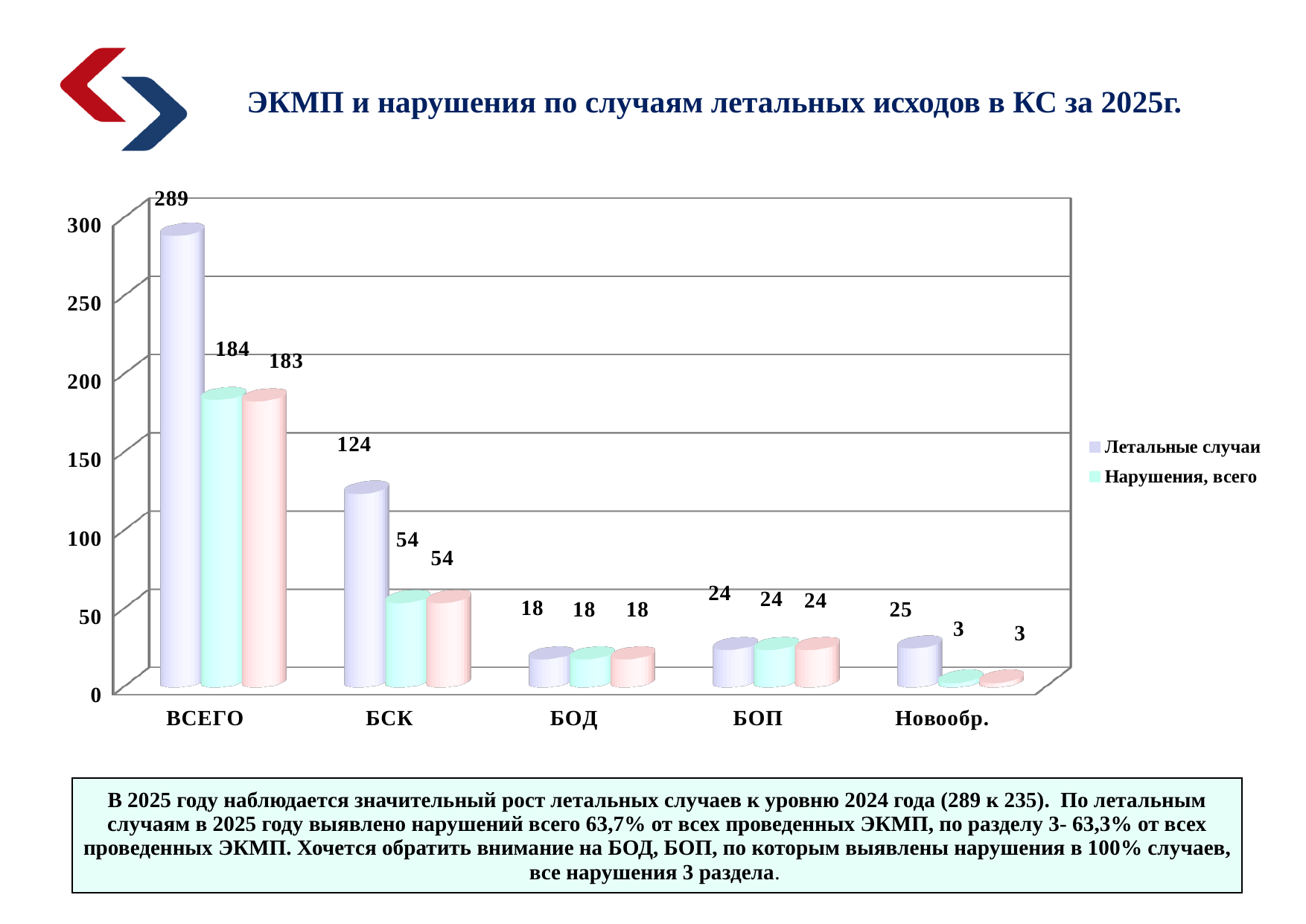
What is the value of Нарушения, всего for ВСЕГО? 184 What is the value of Летальные случаи for Новообр.? 25 Which category has the highest value for Летальные случаи? ВСЕГО What is the value of Летальные случаи for БСК? 124 What is the difference between Летальные случаи and Нарушения, всего for БСК? 70 What kind of chart is shown on the slide? Bar chart What is the value of Нарушения, всего for Новообр.? 3 How many categories are shown on the x axis? 5 What is the difference between Летальные случаи and Нарушения, всего for ВСЕГО? 105 Which category has the lowest value for Летальные случаи? БОД Which is larger: Летальные случаи for БСК or for БОП? БСК How many series does the legend list? 2